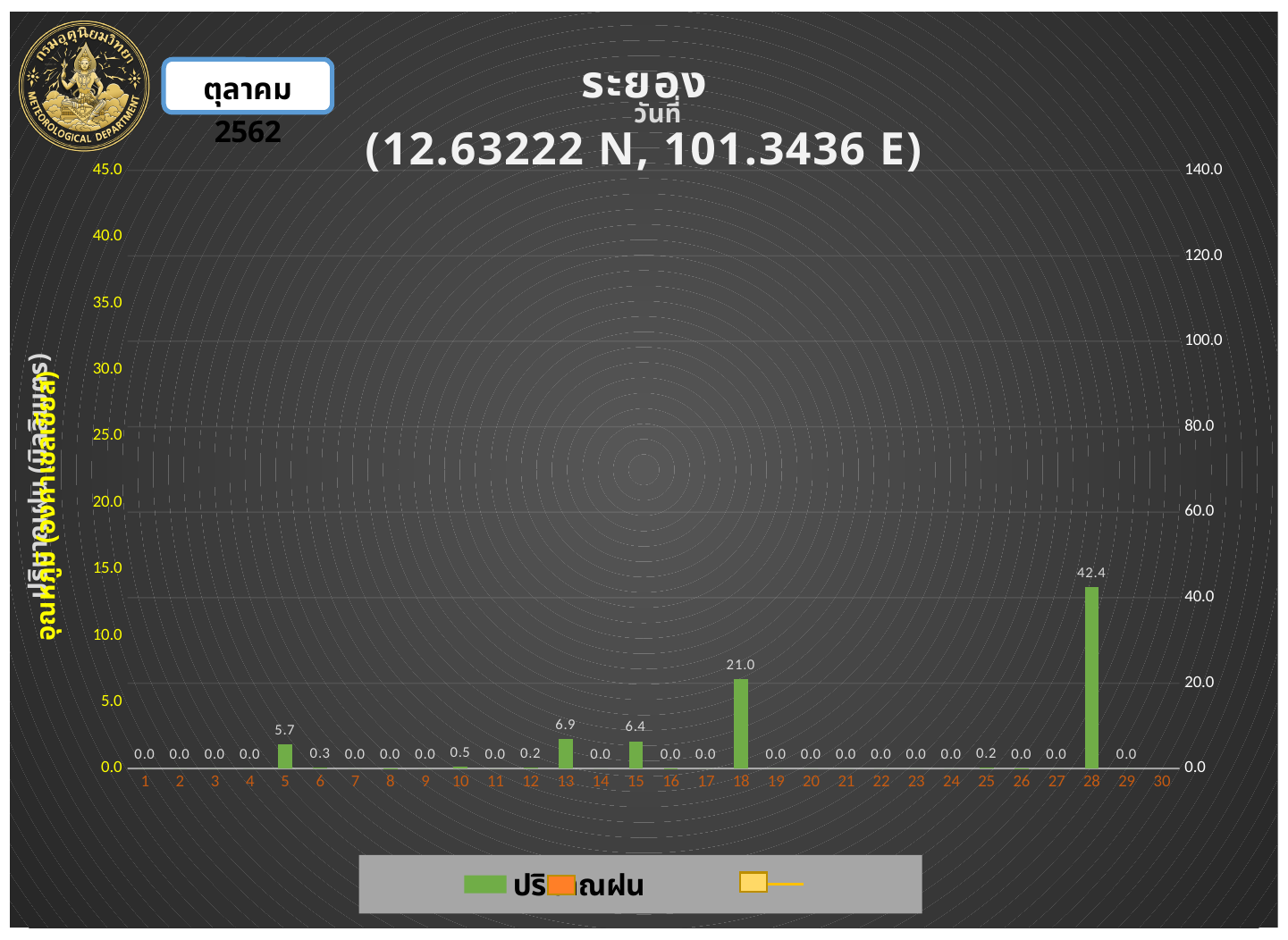
What is the value for day 6? 0.3 What is the value for day 15? 6.4 What is the value for day 18? 21.0 What is the difference between the values for day 28 and day 18? 21.4 What is the value for day 5? 5.7 What is the value for day 28? 42.4 Which day has the highest value? 28 What is the value for day 13? 6.9 How many days are shown on the x axis? 30 Which is larger, the value for day 13 or day 15? Day 13 What kind of chart is this? Bar chart What coordinates are shown in the chart title? (12.63222 N, 101.3436 E)